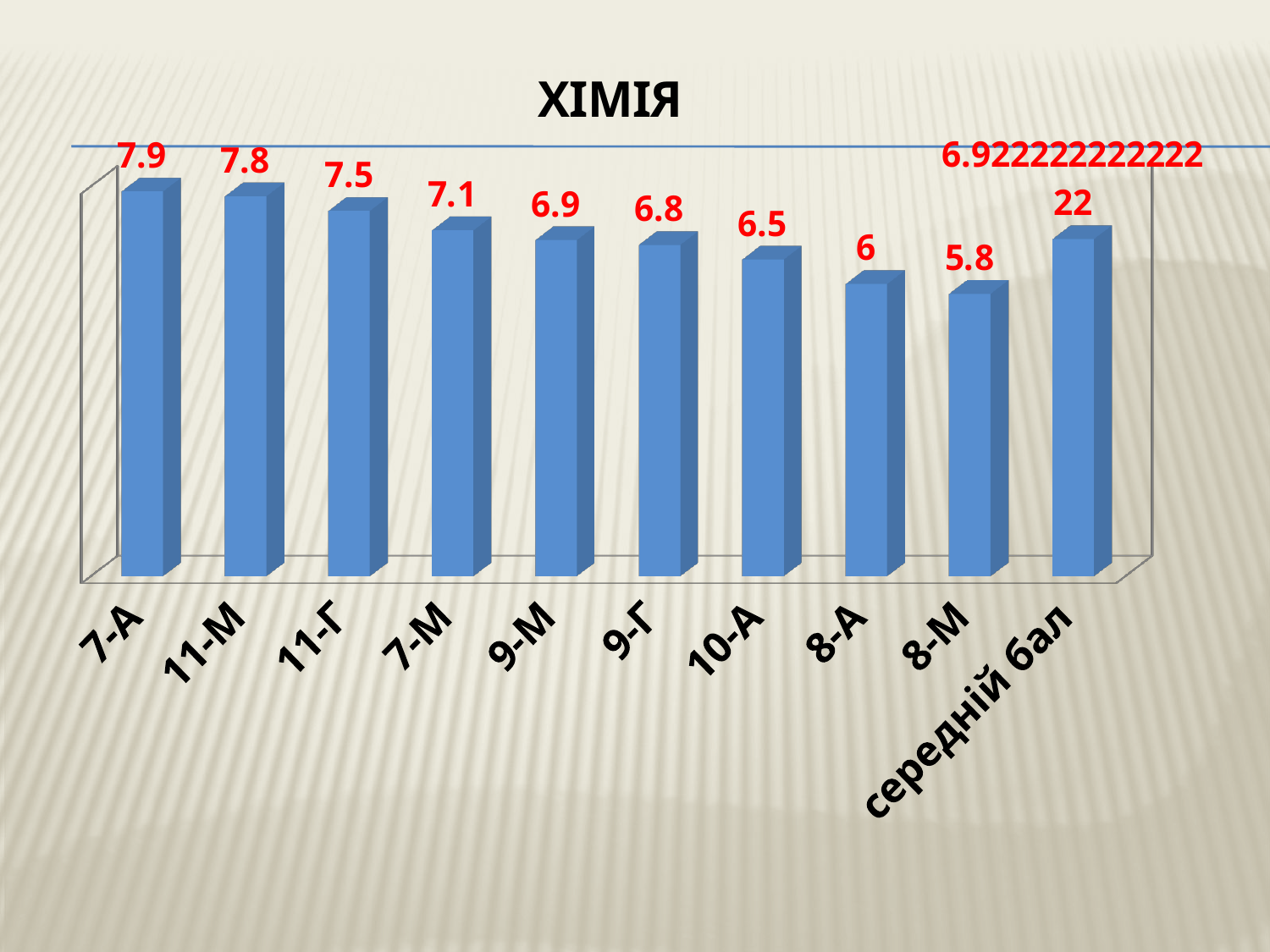
How many categories are shown on the x axis? 10 What is the difference between the values for 7-А and 8-М? 2.1 What is the title of the chart? ХІМІЯ What is the difference between the values for 11-М and 7-М? 0.7 What kind of chart is this? bar chart What is the value for 8-А? 6 Which is larger, the value for 11-Г or the value for 7-М? 11-Г What is the value for 10-А? 6.5 Which class has the highest value? 7-А What is the value for 9-Г? 6.8 What is the value for 7-А? 7.9 Which class has the lowest value? 8-М